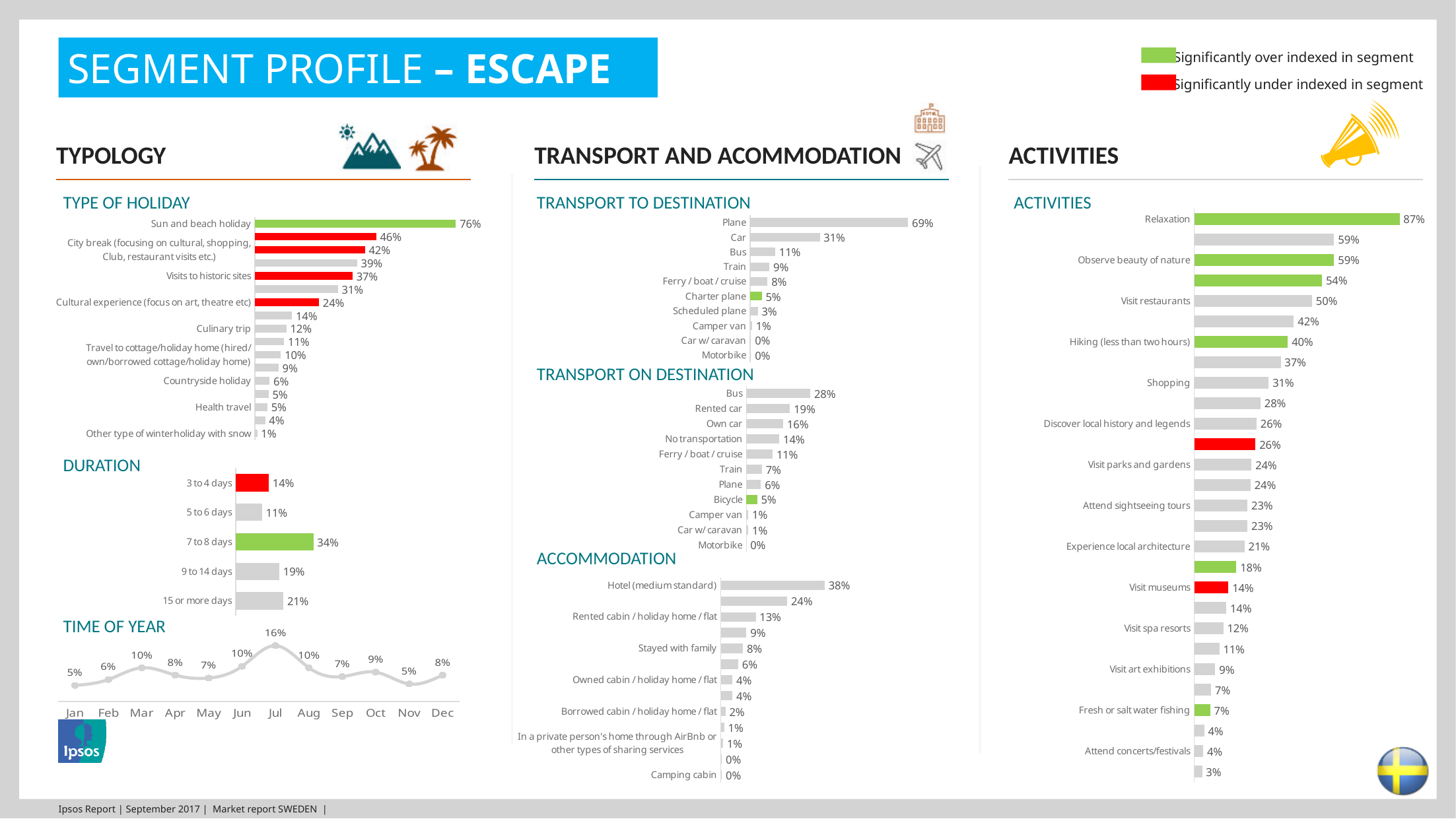
In the Transport on Destination chart, what is the value for Rented car? 19% In the Activities chart, what is the value for Hiking (less than two hours)? 40% In the Duration chart, what is the difference between 15 or more days and 9 to 14 days? 2% In the Accommodation chart, what is the value for Hotel (medium standard)? 38% In the Type of Holiday chart, what is the value for Visits to historic sites? 37% In the Transport to Destination chart, what is the value for Plane? 69% In the Type of Holiday chart, what is the value for Sun and beach holiday? 76% In the Transport to Destination chart, which is larger, Bus or Train? Bus How many categories are shown in the Transport on Destination chart? 11 What kind of chart is the Time of Year chart? Line chart In the Duration chart, which category has the highest value? 7 to 8 days In the Time of Year chart, which month has the highest value? Jul